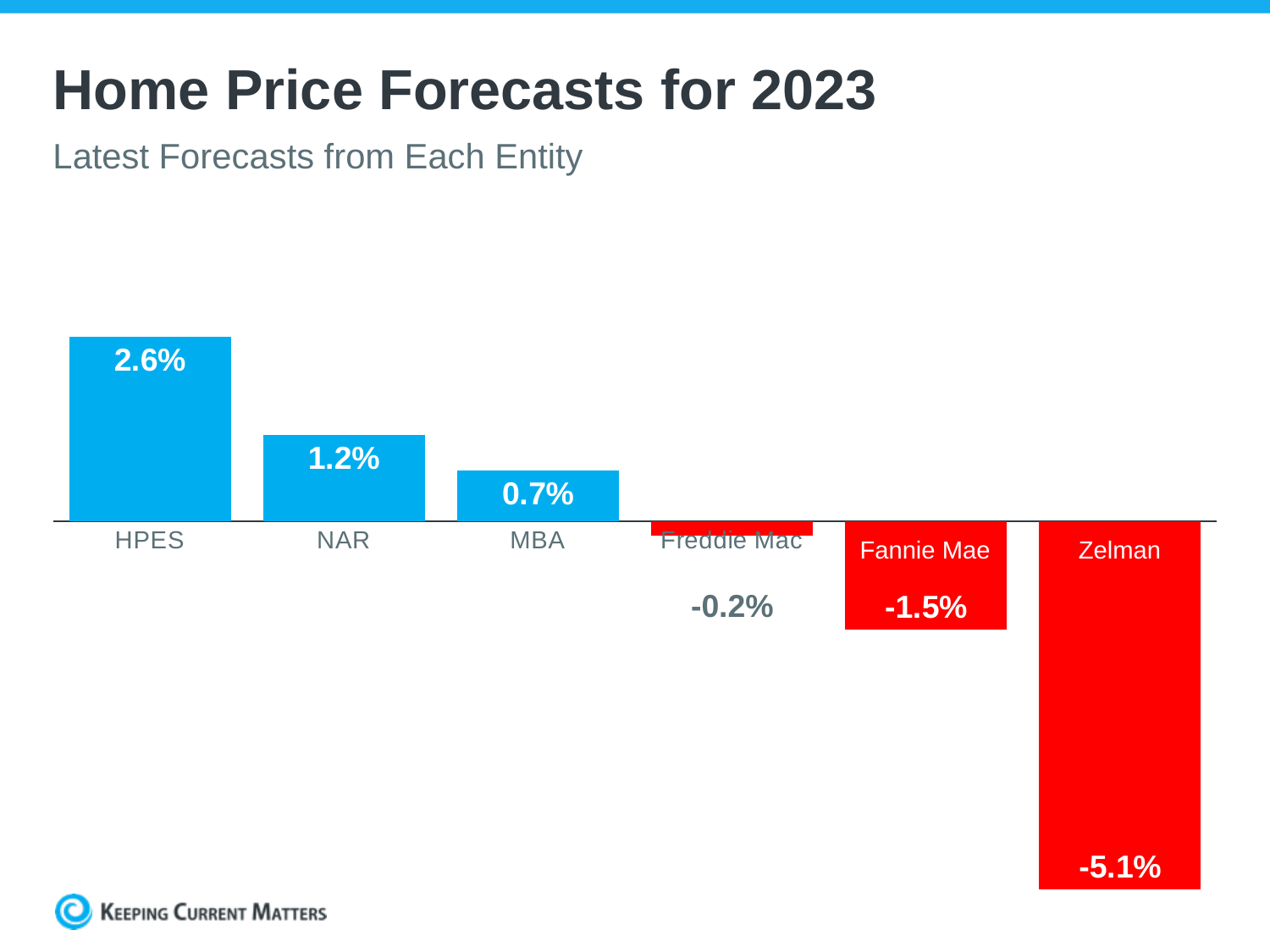
What type of chart is shown on the slide? Bar chart What is the home price forecast for 2023 from Freddie Mac? -0.2% Which entity has the lowest home price forecast for 2023? Zelman How many entities are shown in the chart? 6 Which forecast is larger, MBA or Fannie Mae? MBA What is the home price forecast for 2023 from Zelman? -5.1% Which entity has the highest home price forecast for 2023? HPES What is the difference between the Fannie Mae forecast and the Zelman forecast? 3.6% What is the home price forecast for 2023 from HPES? 2.6% What is the difference between the HPES forecast and the NAR forecast? 1.4% What is the home price forecast for 2023 from NAR? 1.2% Do the forecast values rise or fall moving from left to right across the chart? Fall